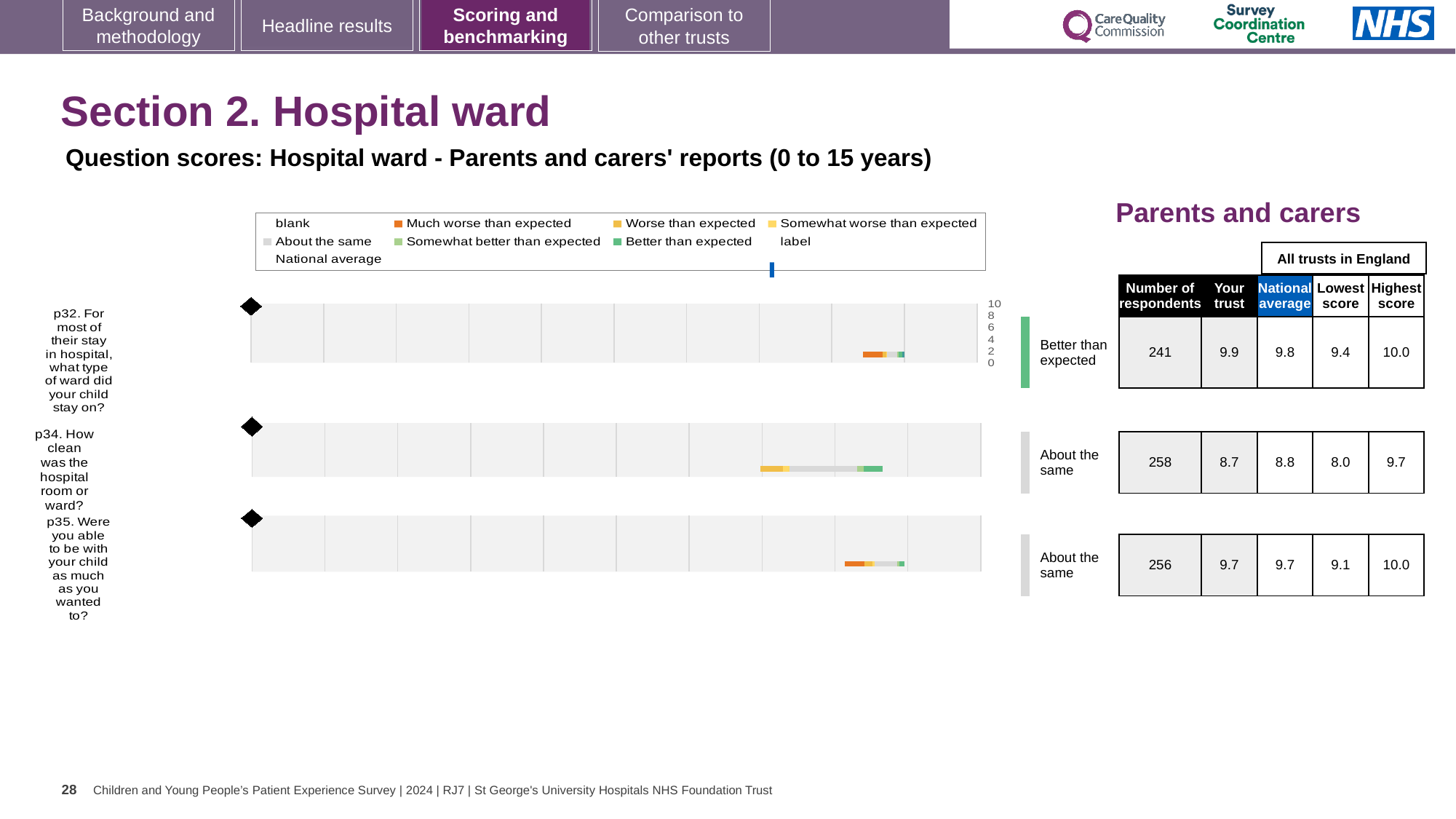
What colour represents 'Much worse than expected' in the legend? Orange Which question has the lowest 'Your trust' score? p34 What is the national average score for p34 (how clean was the hospital room or ward)? 8.8 What is the lowest score across all trusts in England for p35? 9.1 Which question has the highest 'Your trust' score? p32 What kind of chart is used to show the question scores on this slide? Bar chart How many questions (p32, p34, p35) are plotted on the slide? 3 What is the 'Your trust' score for p32 (what type of ward did your child stay on)? 9.9 What benchmark category is shown for p32? Better than expected How many respondents answered p35 (were you able to be with your child as much as you wanted to)? 256 For p32, what is the difference between the highest score and the lowest score across all trusts in England? 0.6 For p34, which is larger: the 'Your trust' score or the national average? National average